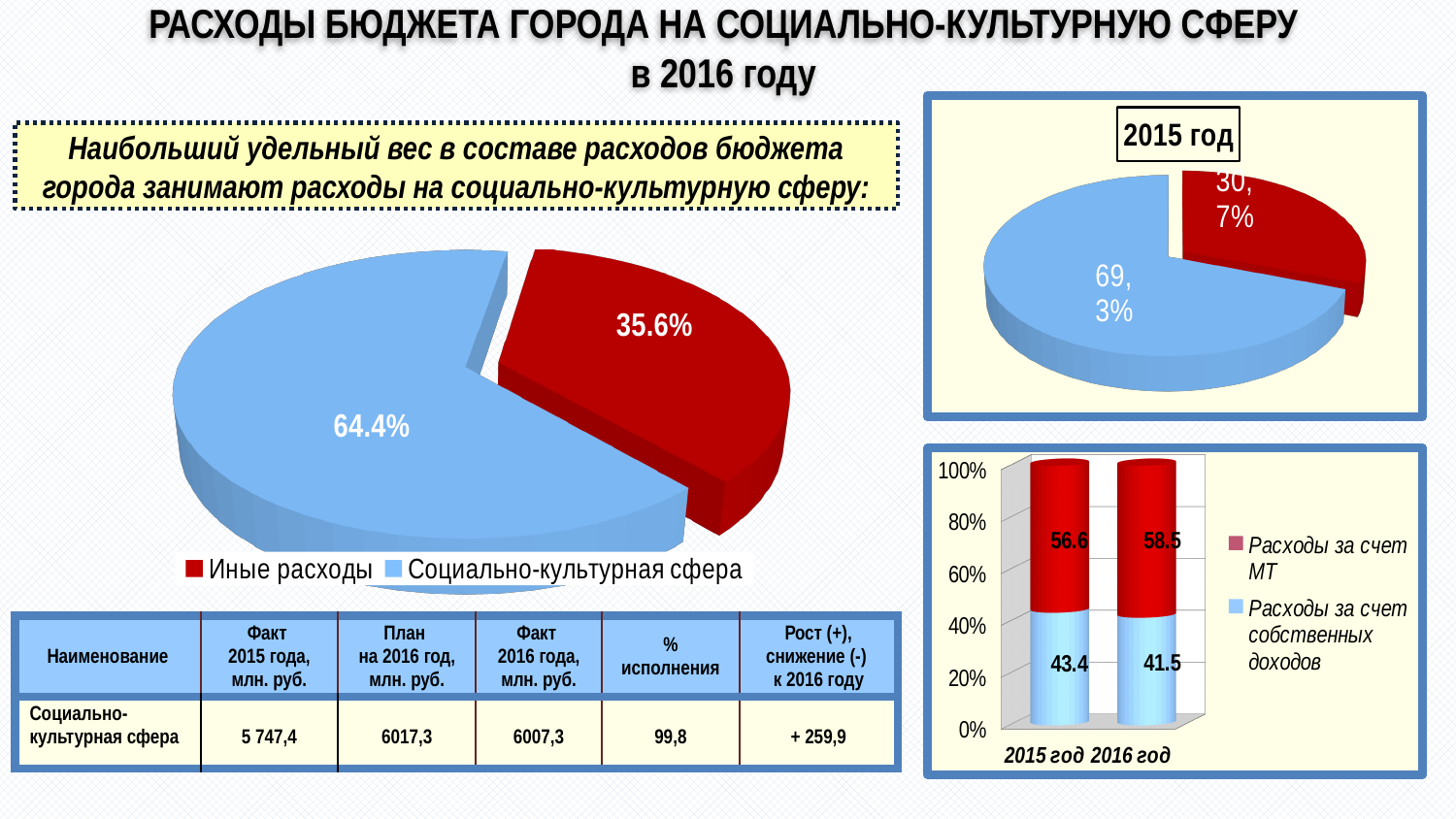
In the stacked bar chart in the bottom right, how many series does the legend list? 2 In the large pie chart on the left, how many categories does the legend list? 2 In the large pie chart on the left, what colour is the slice for Иные расходы? Red In the stacked bar chart in the bottom right, what is the value for Расходы за счет МТ in 2016 год? 58.5 In the stacked bar chart in the bottom right, which year has the larger value for Расходы за счет собственных доходов, 2015 год or 2016 год? 2015 год In the large pie chart on the left, what share is shown for Иные расходы? 35.6% In the pie chart titled 2015 год, what value is shown on the blue slice? 69,3% In the large pie chart on the left, which category has the larger share? Социально-культурная сфера In the large pie chart on the left, what share is shown for Социально-культурная сфера? 64.4% In the stacked bar chart in the bottom right, what is the value for Расходы за счет собственных доходов in 2015 год? 43.4 In the pie chart titled 2015 год, what value is shown on the red slice? 30,7% What type of chart is the chart in the bottom right of the slide? Stacked bar chart